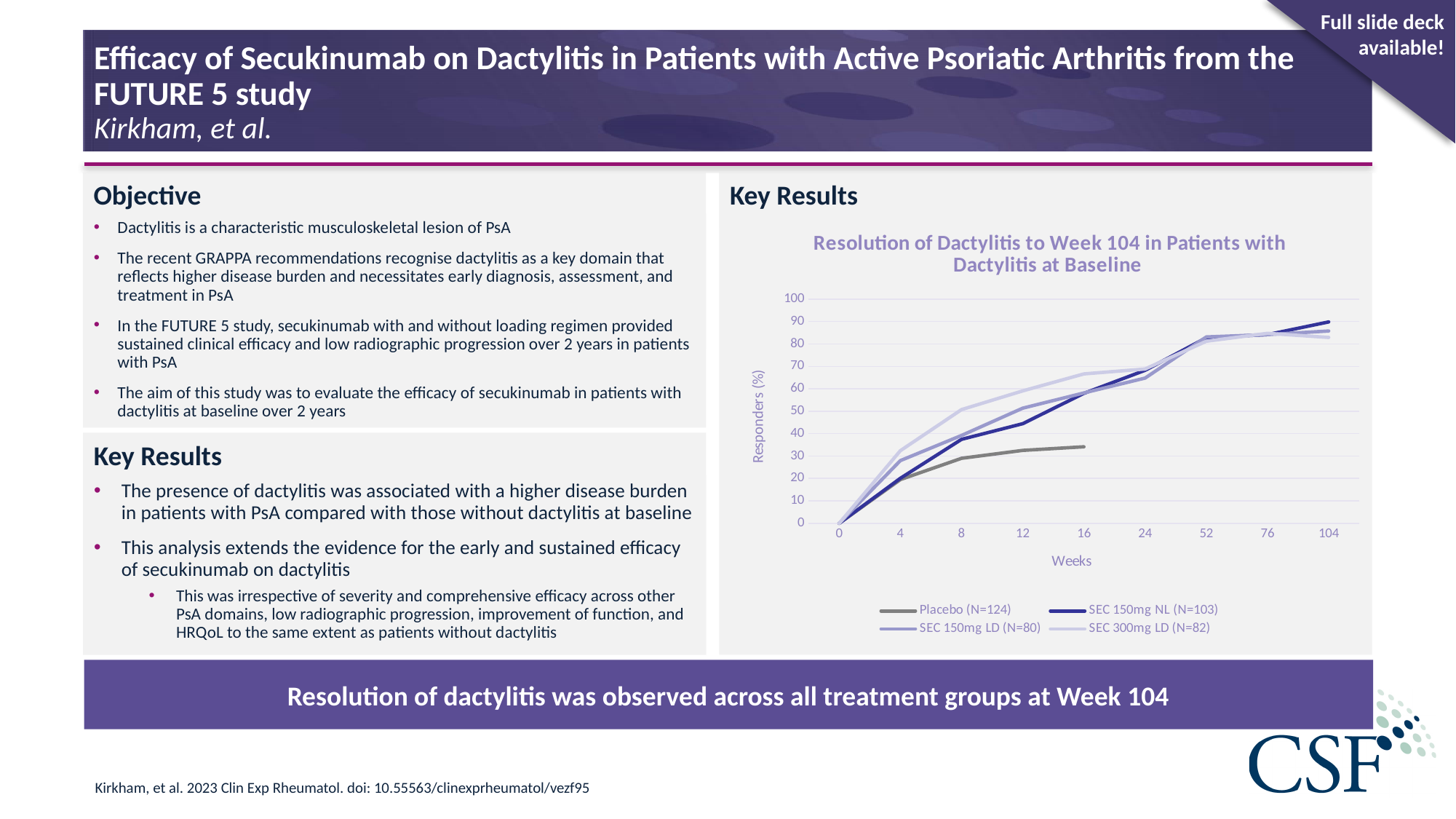
Do the responder percentages for SEC 150mg NL (N=103) rise or fall from week 0 to week 104? rise At week 104, which is larger: the value for SEC 150mg NL (N=103) or the value for SEC 300mg LD (N=82)? SEC 150mg NL (N=103) What is the label of the y axis of the chart? Responders (%) Which series has the lowest responder percentage at week 8? Placebo (N=124) What kind of chart is shown under Key Results? line chart How many week time points are marked on the x axis of the chart? 9 Is the value for SEC 150mg NL (N=103) at week 104 greater or less than 80? greater How many series does the legend of the chart list? 4 Is the value for Placebo (N=124) at week 8 greater or less than 40? less Is the value for SEC 300mg LD (N=82) at week 8 greater or less than 40? greater What is the title of the chart? Resolution of Dactylitis to Week 104 in Patients with Dactylitis at Baseline